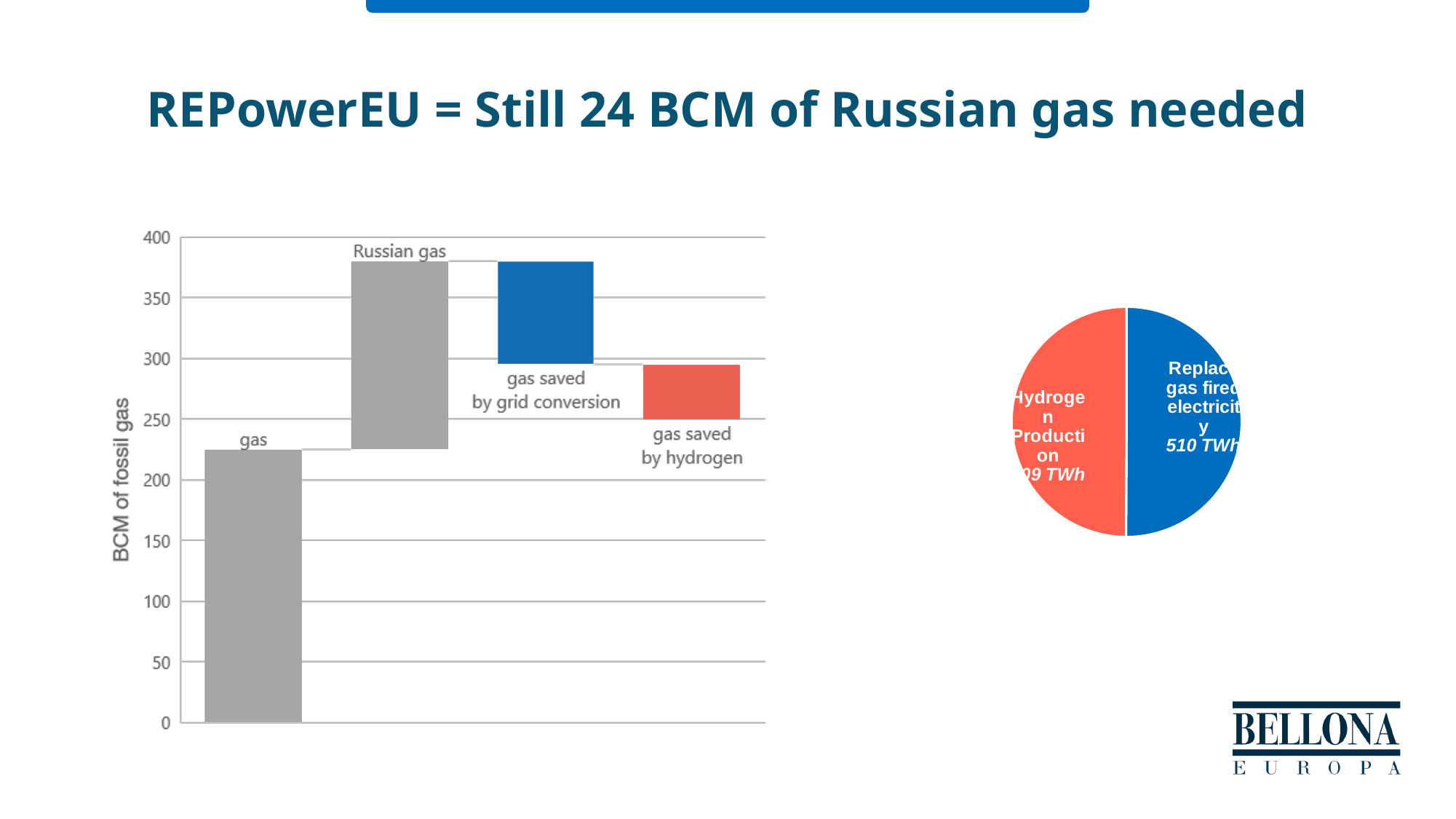
In the bar chart on the left, what colour is the 'gas saved by grid conversion' bar? blue In the pie chart on the right, what value is shown for 'Replace gas fired electricity'? 510 TWh What kind of chart is the chart on the right of the slide? pie chart In the bar chart on the left, is the value for 'gas' greater or less than 250? less How many bars are plotted in the bar chart on the left? 4 What is the y-axis title of the bar chart on the left? BCM of fossil gas In the bar chart on the left, is the top of the 'Russian gas' bar greater or less than 350? greater In the bar chart on the left, is the value for 'gas' greater or less than 200? greater What kind of chart is the chart on the left of the slide? bar chart How many slices does the pie chart on the right have? 2